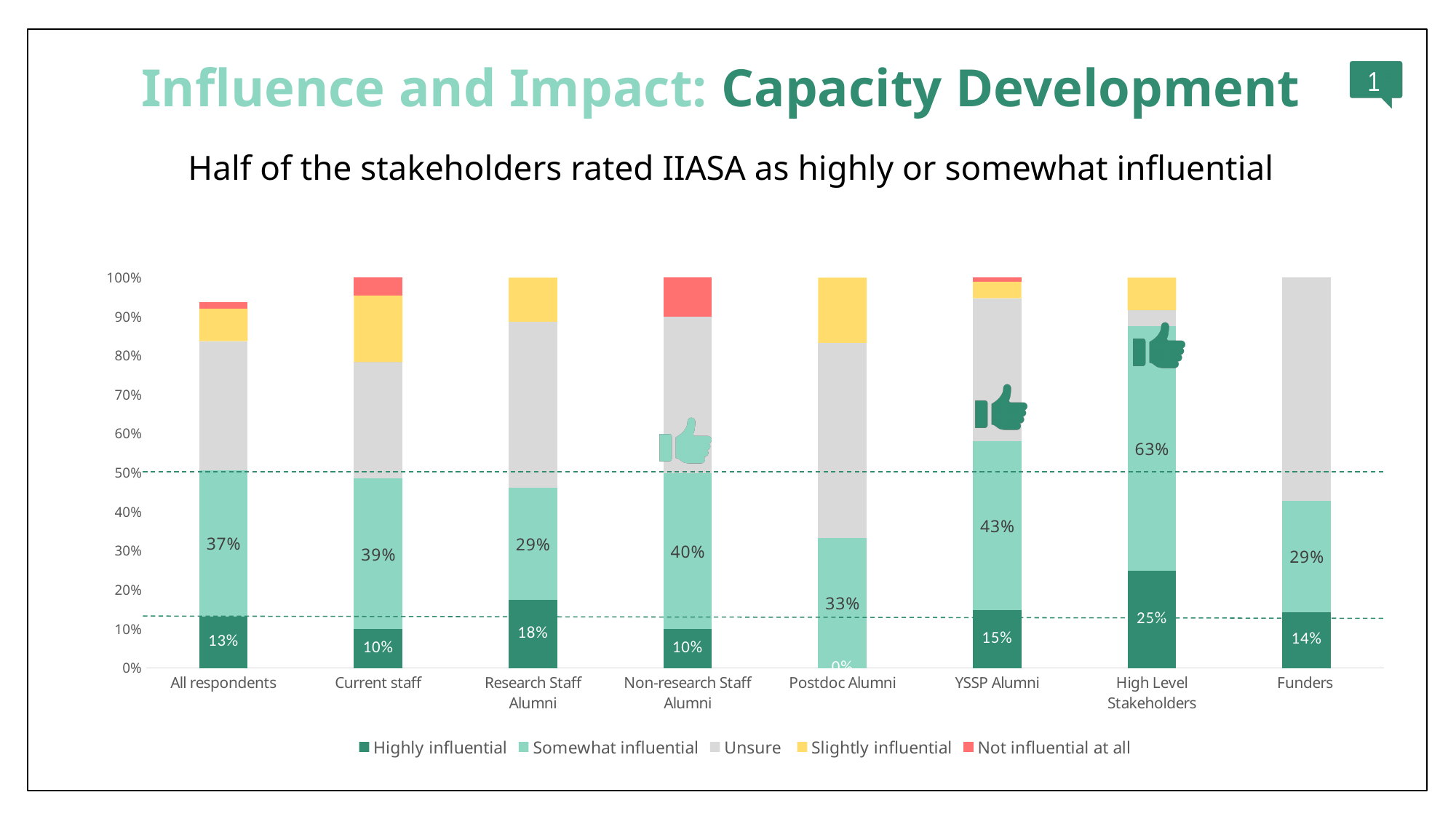
How many series does the legend list? 5 Which has a larger 'Highly influential' value, Current staff or Funders? Funders What is the 'Somewhat influential' value for Postdoc Alumni? 33% How many respondent categories are shown along the x axis? 8 What type of chart is shown on the slide? Stacked bar chart Which series is shown in yellow in the legend? Slightly influential What is the 'Highly influential' value for Research Staff Alumni? 18% What is the difference between the 'Somewhat influential' values for YSSP Alumni and Funders? 14% What percentage of High Level Stakeholders rated IIASA as somewhat influential? 63% What is the subtitle text above the chart? Half of the stakeholders rated IIASA as highly or somewhat influential Which category has the highest 'Highly influential' value? High Level Stakeholders Which category has the lowest 'Highly influential' value? Postdoc Alumni